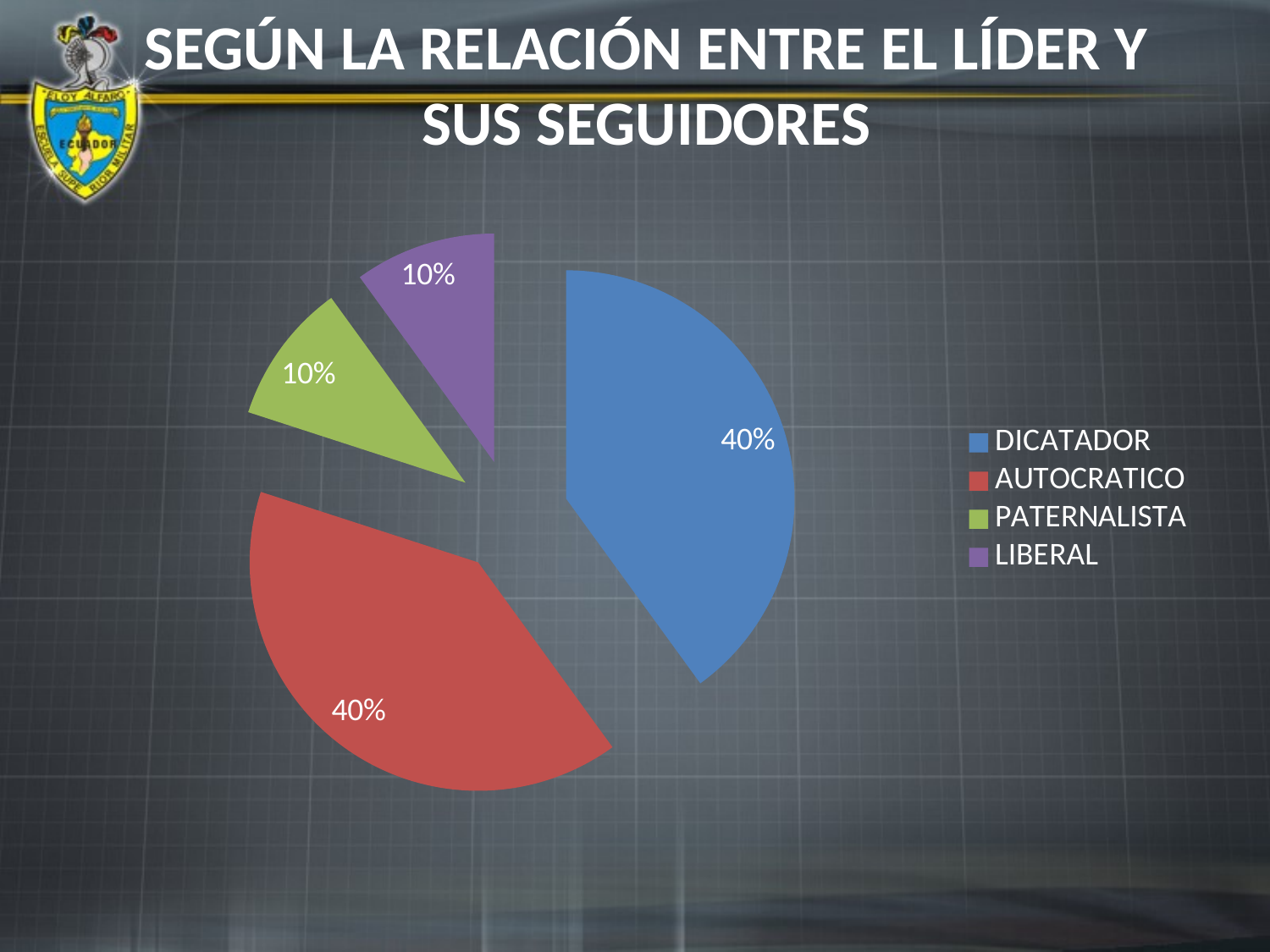
What is the difference in percentage points between the AUTOCRATICO slice and the LIBERAL slice? 30 percentage points How many slices does the pie chart have? 4 How many entries does the legend list? 4 What percentage of the pie does the LIBERAL slice represent? 10% What is the title of the slide containing the pie chart? SEGÚN LA RELACIÓN ENTRE EL LÍDER Y SUS SEGUIDORES What percentage of the pie does the DICATADOR slice represent? 40% What kind of chart is shown on the slide? pie chart What colour is the PATERNALISTA slice in the pie chart? green What percentage of the pie does the PATERNALISTA slice represent? 10% Which is larger, the LIBERAL slice or the AUTOCRATICO slice? AUTOCRATICO Which is larger, the DICATADOR slice or the PATERNALISTA slice? DICATADOR What percentage of the pie does the AUTOCRATICO slice represent? 40%